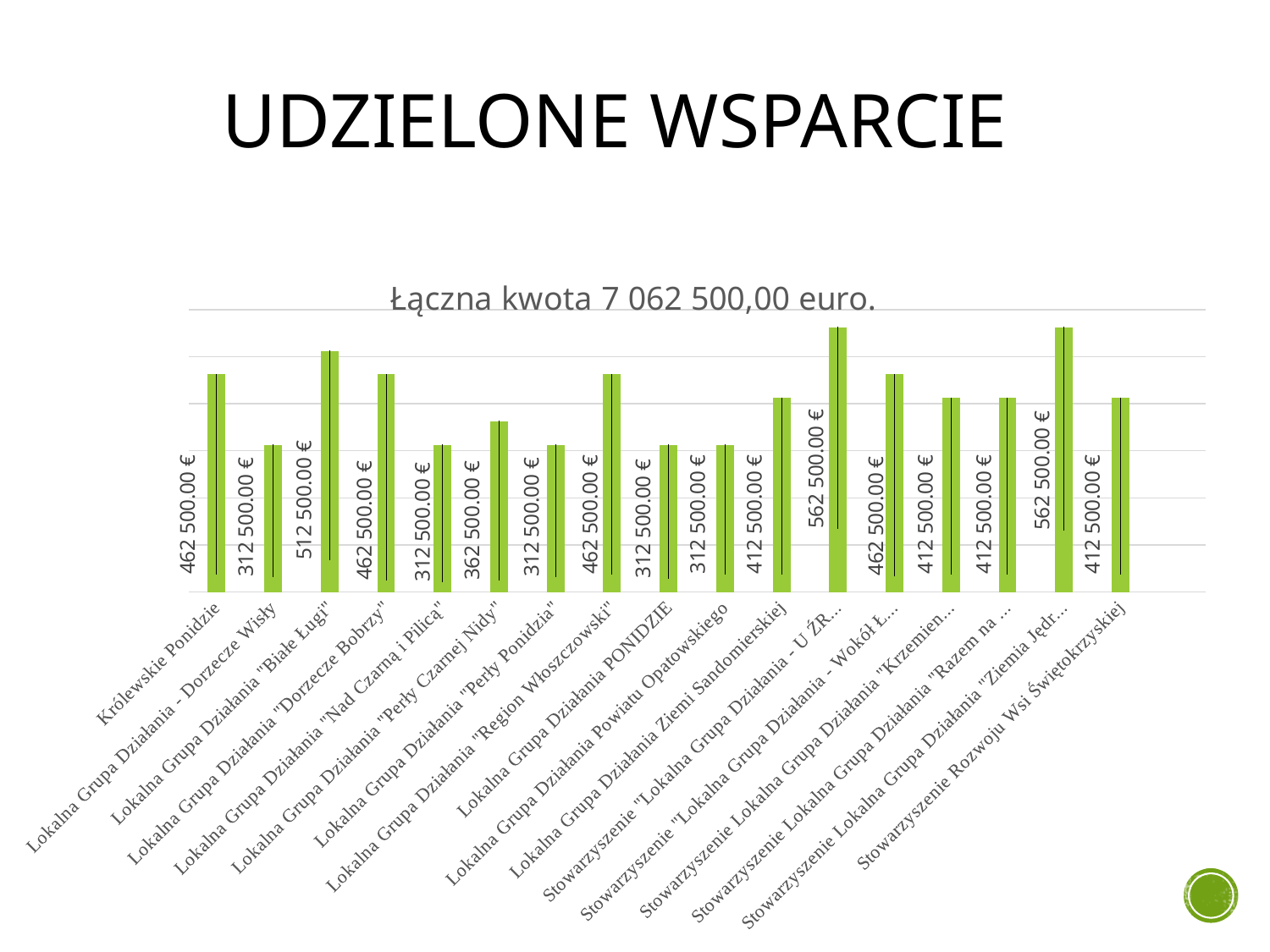
What kind of chart is shown on the slide? Bar chart What is the value for Królewskie Ponidzie? 462 500.00 € What is the title of the chart? Łączna kwota 7 062 500,00 euro. How many bars (categories) are plotted in the chart? 17 What is the value for Lokalna Grupa Działania "Perły Czarnej Nidy"? 362 500.00 € What is the value for Stowarzyszenie Rozwoju Wsi Świętokrzyskiej? 412 500.00 € What is the value for Lokalna Grupa Działania "Białe Ługi"? 512 500.00 € What is the value for Lokalna Grupa Działania Ziemi Sandomierskiej? 412 500.00 € What is the lowest value shown in the chart? 312 500.00 € What is the difference between the values for Lokalna Grupa Działania "Białe Ługi" and Lokalna Grupa Działania - Dorzecze Wisły? 200 000.00 € Which is larger, the value for Lokalna Grupa Działania "Dorzecze Bobrzy" or the value for Lokalna Grupa Działania "Nad Czarną i Pilicą"? Lokalna Grupa Działania "Dorzecze Bobrzy" What is the value for Lokalna Grupa Działania Powiatu Opatowskiego? 312 500.00 €